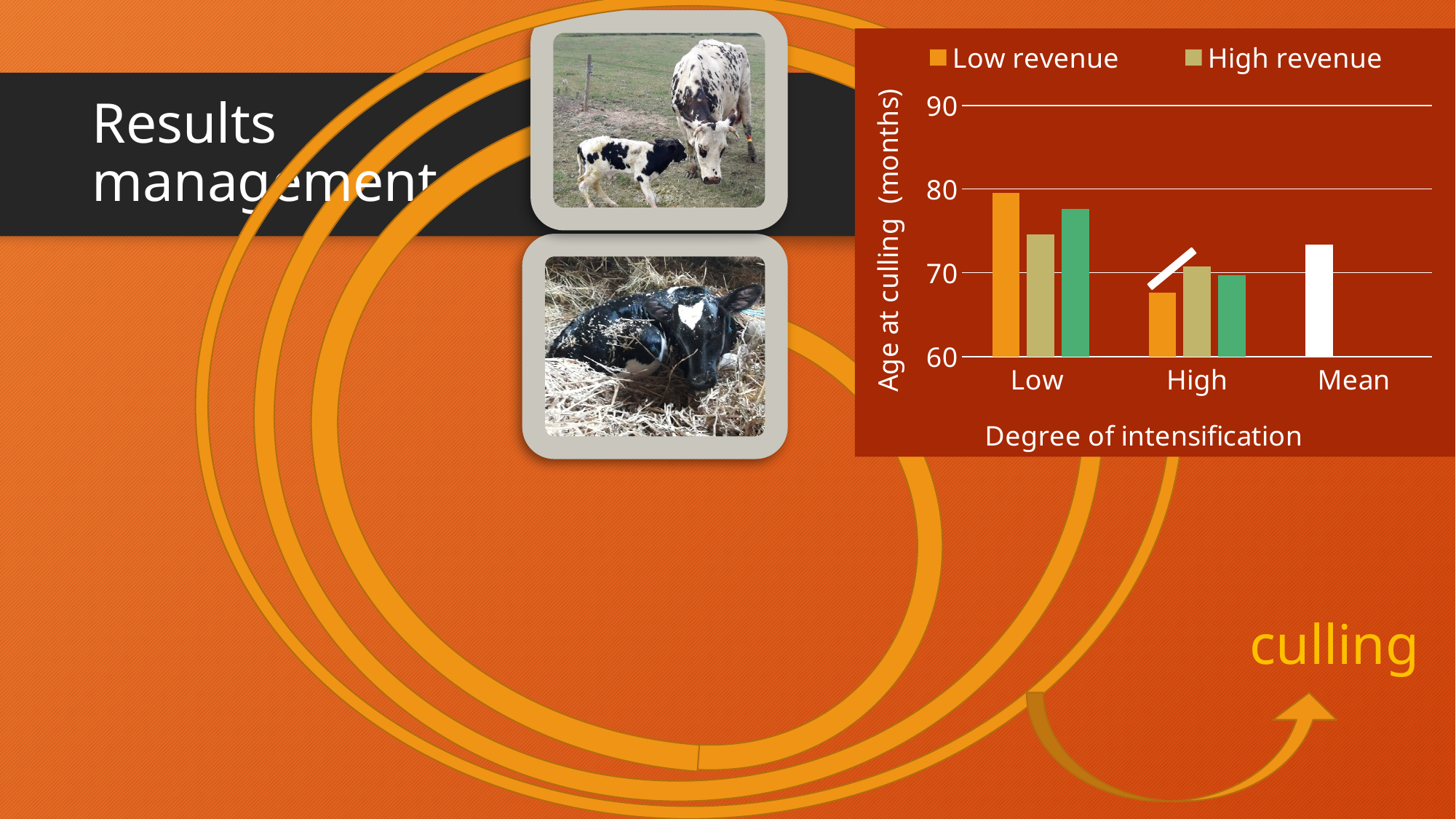
Is the Low revenue value for the High degree of intensification greater or less than 70? less How many categories are shown on the x axis of the chart? 3 What is the label of the x axis of the chart? Degree of intensification Which is larger for the Low revenue series: the value for Low or the value for High degree of intensification? Low Which is larger for the High revenue series: the value for Low or the value for High degree of intensification? Low Is the Low revenue value for the Low degree of intensification greater or less than 70? greater How many series does the chart legend list? 2 Is the value of the Mean bar greater or less than 70? greater Does the Low revenue series rise or fall from the Low to the High degree of intensification? fall What is the label of the y axis of the chart? Age at culling (months) What kind of chart is shown on the slide? bar chart